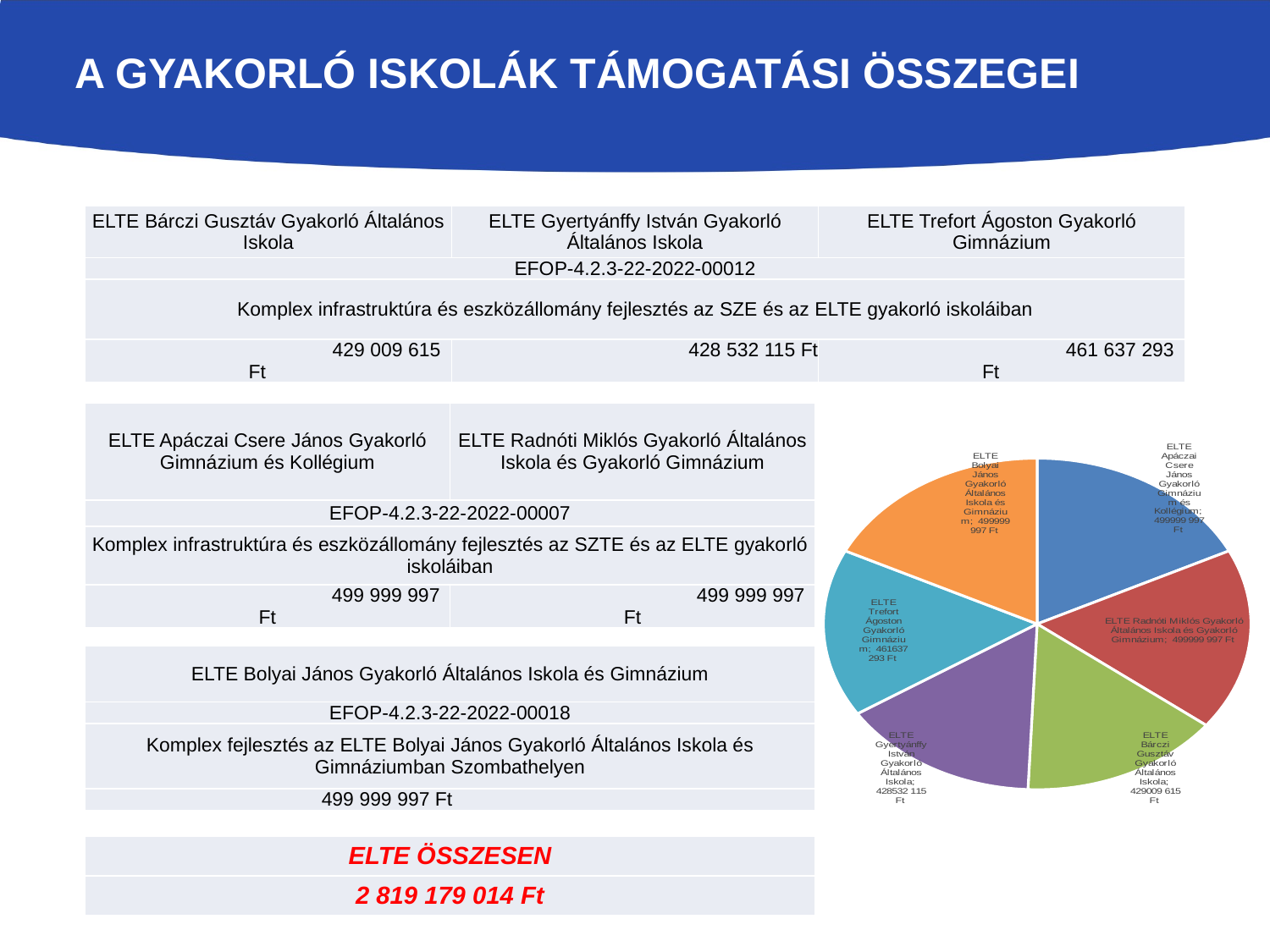
What colour is the slice for ELTE Apáczai Csere János Gyakorló Gimnázium és Kollégium in the pie chart? blue In the pie chart, what is the difference between the value for ELTE Trefort Ágoston Gyakorló Gimnázium and the value for ELTE Bárczi Gusztáv Gyakorló Általános Iskola? 32 627 678 Ft How many slices does the pie chart have? 6 In the pie chart, what value is shown for ELTE Radnóti Miklós Gyakorló Általános Iskola és Gyakorló Gimnázium? 499999 997 Ft In the pie chart, what is the difference between the value for ELTE Bolyai János Gyakorló Általános Iskola és Gimnázium and the value for ELTE Trefort Ágoston Gyakorló Gimnázium? 38 362 704 Ft What kind of chart is shown on the right side of the slide? pie chart In the pie chart, what value is shown for ELTE Bolyai János Gyakorló Általános Iskola és Gimnázium? 499999 997 Ft In the pie chart, which is larger: the value for ELTE Apáczai Csere János Gyakorló Gimnázium és Kollégium or for ELTE Gyertyánffy István Gyakorló Általános Iskola? ELTE Apáczai Csere János Gyakorló Gimnázium és Kollégium In the pie chart, what value is shown for ELTE Gyertyánffy István Gyakorló Általános Iskola? 428532 115 Ft In the pie chart, what value is shown for ELTE Trefort Ágoston Gyakorló Gimnázium? 461637 293 Ft In the pie chart, which is larger: the value for ELTE Trefort Ágoston Gyakorló Gimnázium or for ELTE Bárczi Gusztáv Gyakorló Általános Iskola? ELTE Trefort Ágoston Gyakorló Gimnázium In the pie chart, what value is shown for ELTE Bárczi Gusztáv Gyakorló Általános Iskola? 429009 615 Ft